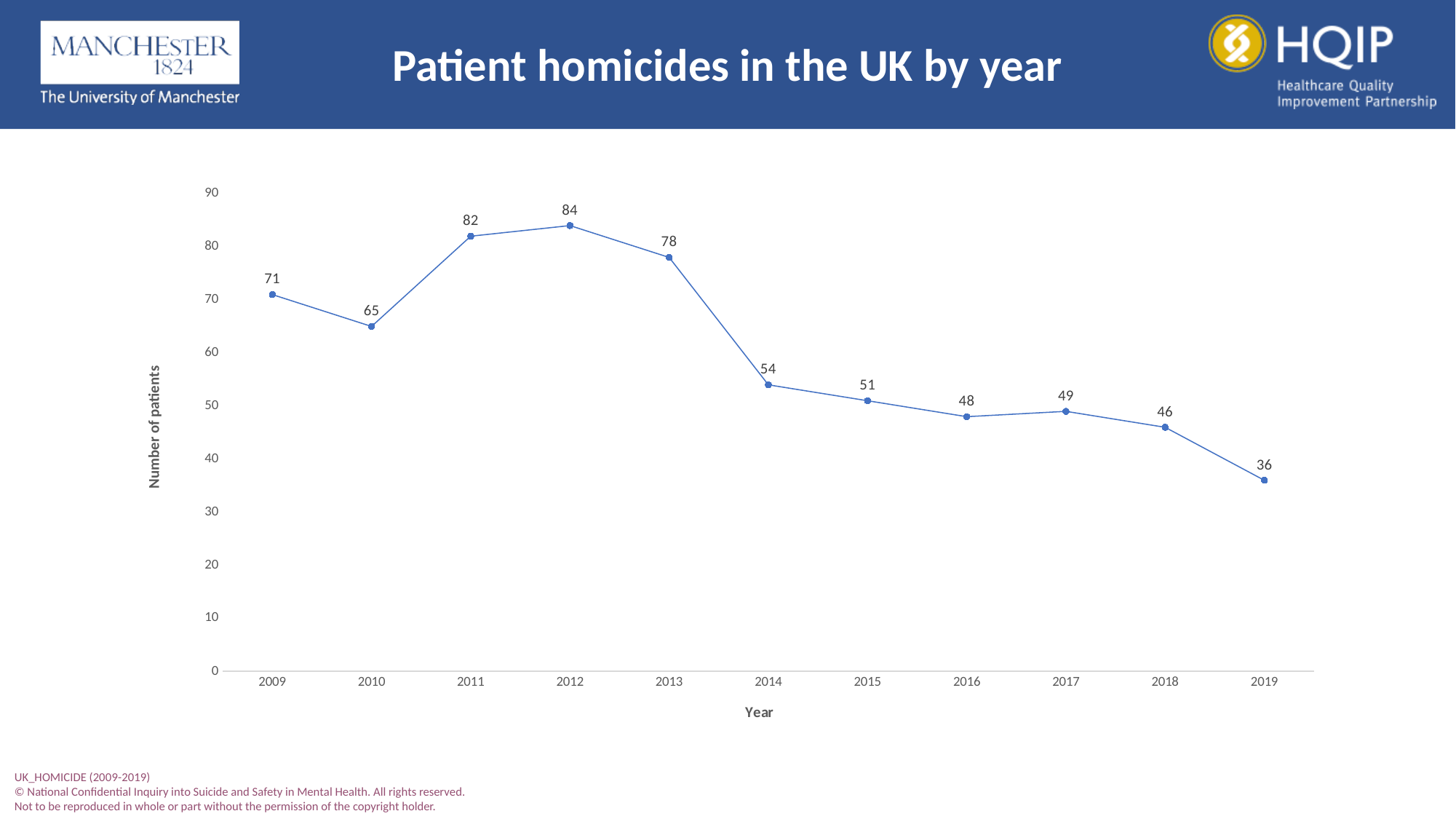
How many years are plotted on the chart? 11 Is the value for 2010 greater or less than 70? less What is the difference between the number of patients in 2013 and 2014? 24 What is the number of patients in 2014? 54 What is the number of patients in 2019? 36 Which year has more patients, 2016 or 2017? 2017 What is the label of the y axis? Number of patients What is the number of patients in 2012? 84 Which year has the lowest number of patients? 2019 What kind of chart is shown on the slide? line chart Do the values rise or fall from 2013 to 2019? fall Which year has the highest number of patients? 2012